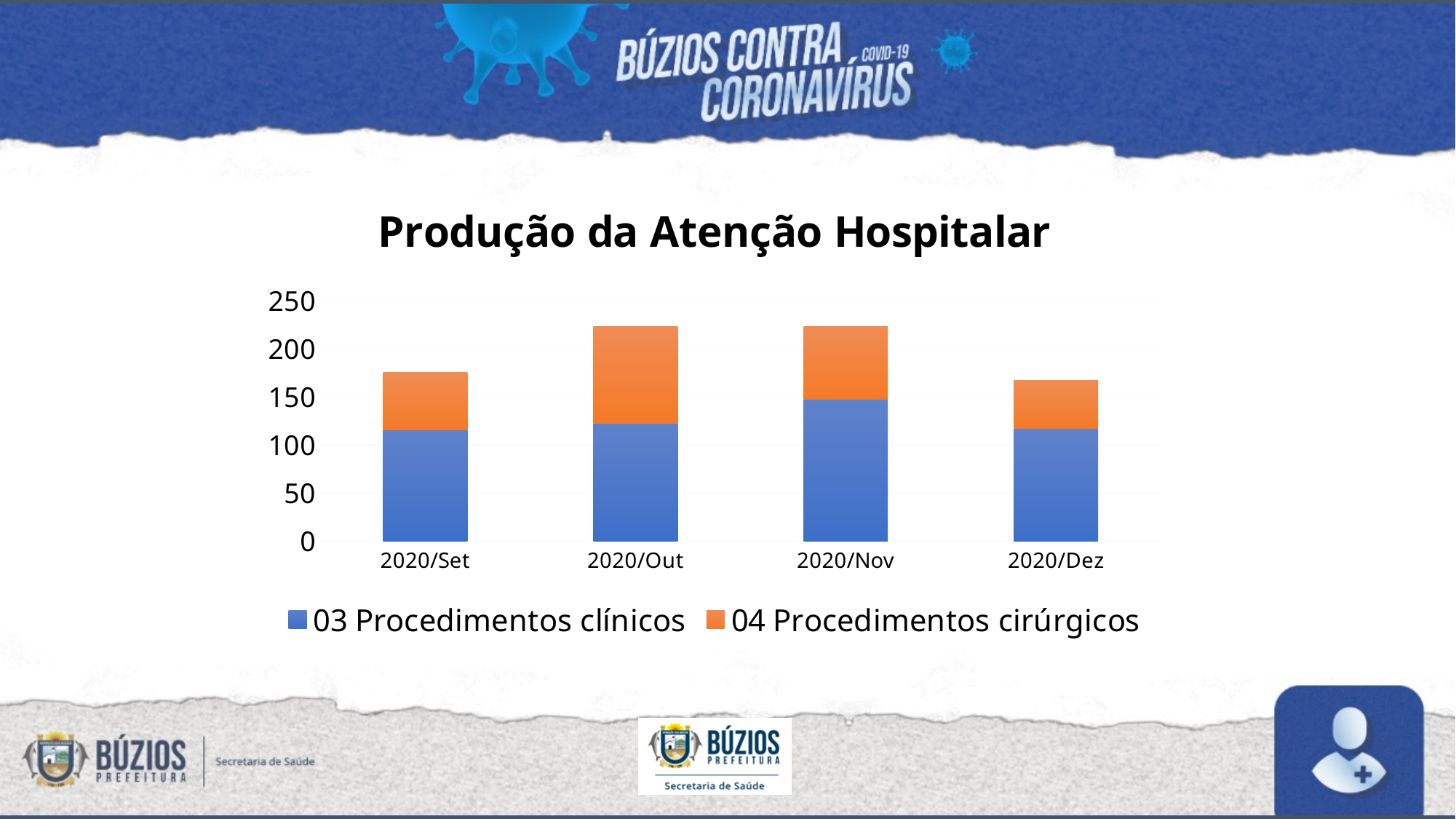
How many series does the legend list? 2 Is the total stacked bar for 2020/Set greater or less than 200? less Is the value for 03 Procedimentos clínicos in 2020/Dez greater or less than 100? greater Which month has the larger total stacked bar, 2020/Out or 2020/Set? 2020/Out Which series is shown in orange? 04 Procedimentos cirúrgicos How many months (categories) are shown on the x axis? 4 Is the total stacked bar for 2020/Dez greater or less than 150? greater Which is larger, the value for 03 Procedimentos clínicos in 2020/Nov or in 2020/Out? 2020/Nov In which month is the value for 03 Procedimentos clínicos highest? 2020/Nov What is the title of the chart? Produção da Atenção Hospitalar What kind of chart is shown on the slide? bar chart